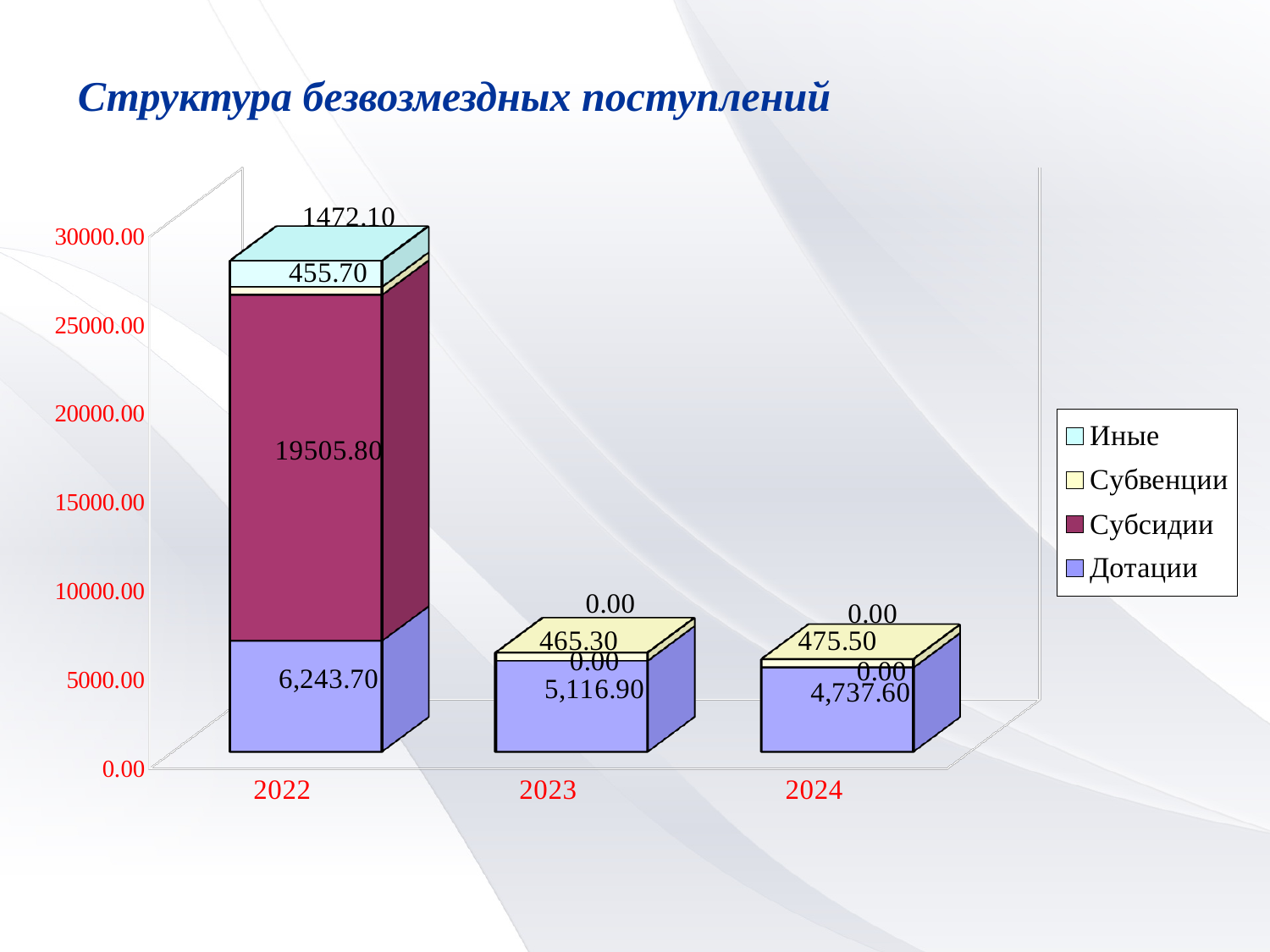
Which year has the highest value for Дотации? 2022 What is the value of Субсидии for 2022? 19505.80 How many years are shown on the x axis? 3 What type of chart is shown on the slide? Stacked bar chart What is the value of Субвенции for 2023? 465.30 How many series does the legend list? 4 What is the difference between the Дотации values for 2022 and 2023? 1,126.80 What is the value of Иные for 2022? 1472.10 What is the total of the stacked bar for 2023? 5,582.20 Which is larger: Субвенции for 2024 or Субвенции for 2023? Субвенции for 2024 What is the value of Дотации for 2024? 4,737.60 Which year has the lowest value for Дотации? 2024